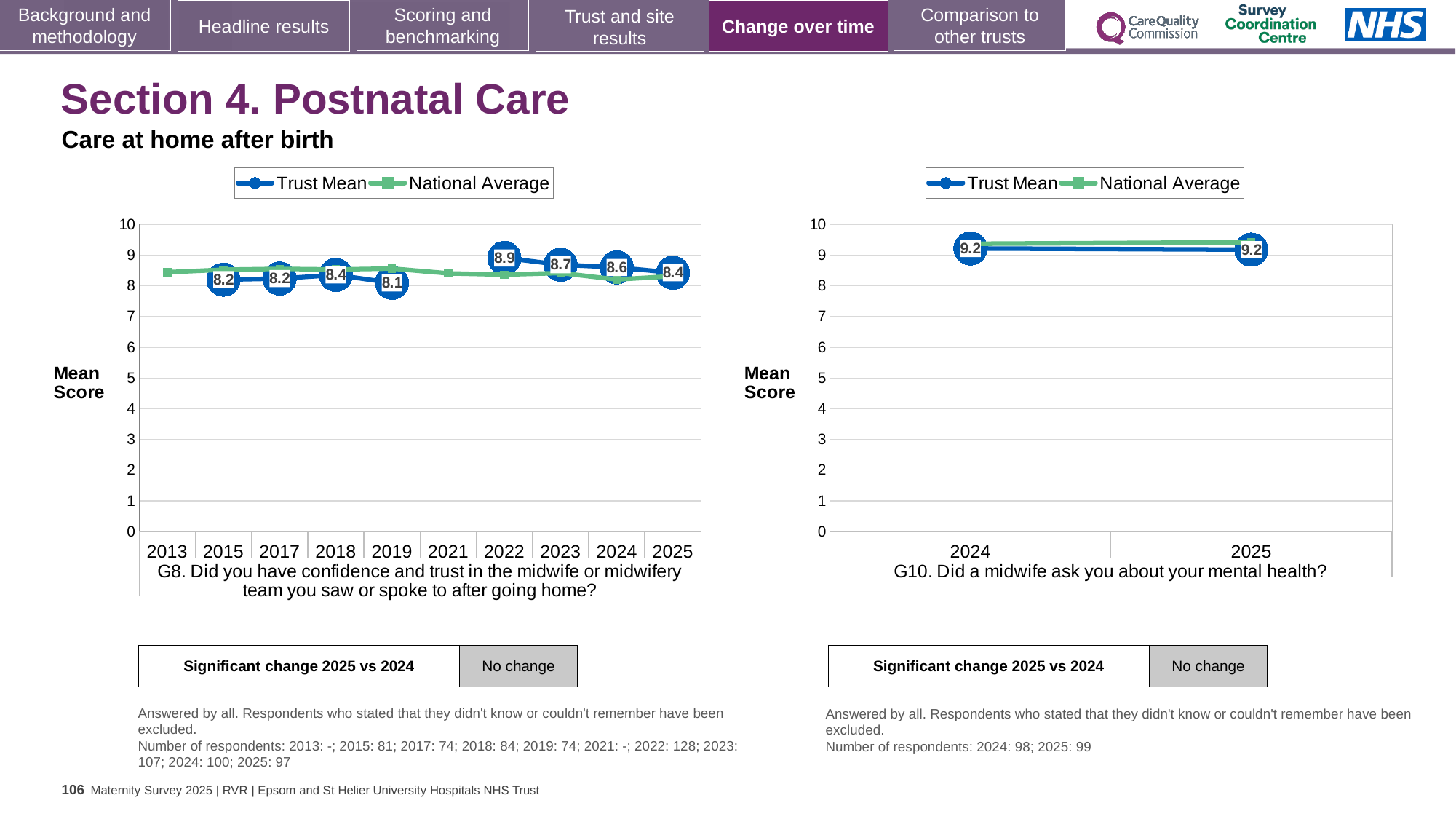
In the left chart (G8), what is the Trust Mean score for 2022? 8.9 In the left chart (G8), how many series does the legend list? 2 In the left chart (G8), is the National Average value for 2013 greater or less than 8? greater In the left chart (G8), which year has the lowest Trust Mean score? 2019 In the left chart (G8), which year has the higher Trust Mean score, 2023 or 2025? 2023 In the left chart (G8), which year has the highest Trust Mean score? 2022 In the right chart (G10), what is the Trust Mean score for 2024? 9.2 In the left chart (G8), how many years are shown on the x axis? 10 In the left chart (G8), what is the difference between the Trust Mean scores for 2022 and 2019? 0.8 In the right chart (G10), is the National Average value for 2025 greater or less than 9? greater What kind of chart is the left chart (G8)? Line chart In the right chart (G10), does the Trust Mean rise, fall or stay the same from 2024 to 2025? Stays the same